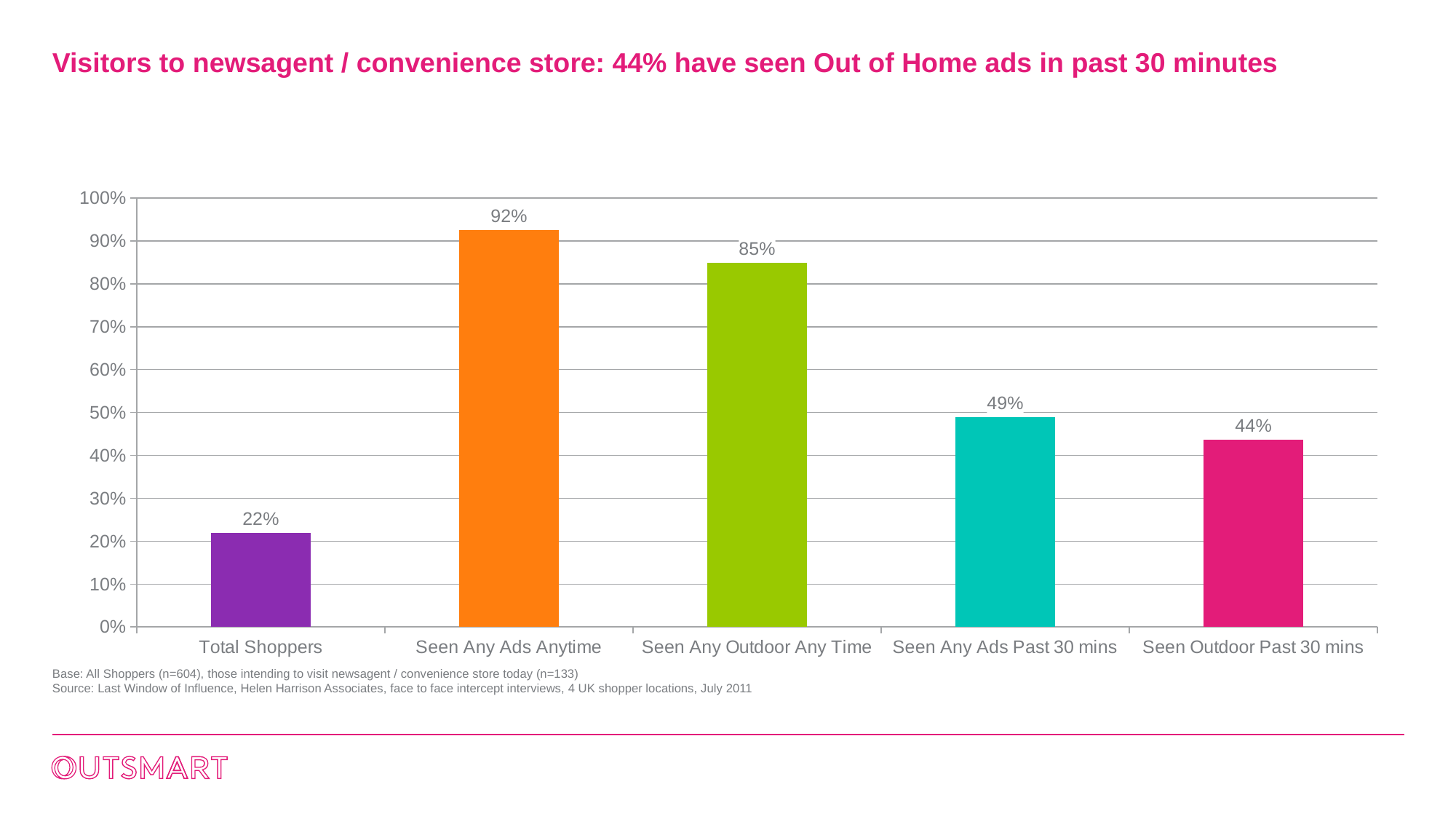
What is the value for Total Shoppers? 22% Which category has the lowest value? Total Shoppers How many categories are shown on the x axis? 5 What is the value for Seen Any Ads Past 30 mins? 49% What is the difference between Seen Any Ads Anytime and Seen Any Outdoor Any Time? 7% Which category has the highest value? Seen Any Ads Anytime What kind of chart is shown on the slide? Bar chart Is the value for Seen Any Outdoor Any Time greater or less than 80%? greater What is the value for Seen Any Ads Anytime? 92% What is the value for Seen Outdoor Past 30 mins? 44% What is the difference between Seen Any Ads Past 30 mins and Seen Outdoor Past 30 mins? 5% Which is larger, Seen Any Outdoor Any Time or Seen Any Ads Past 30 mins? Seen Any Outdoor Any Time